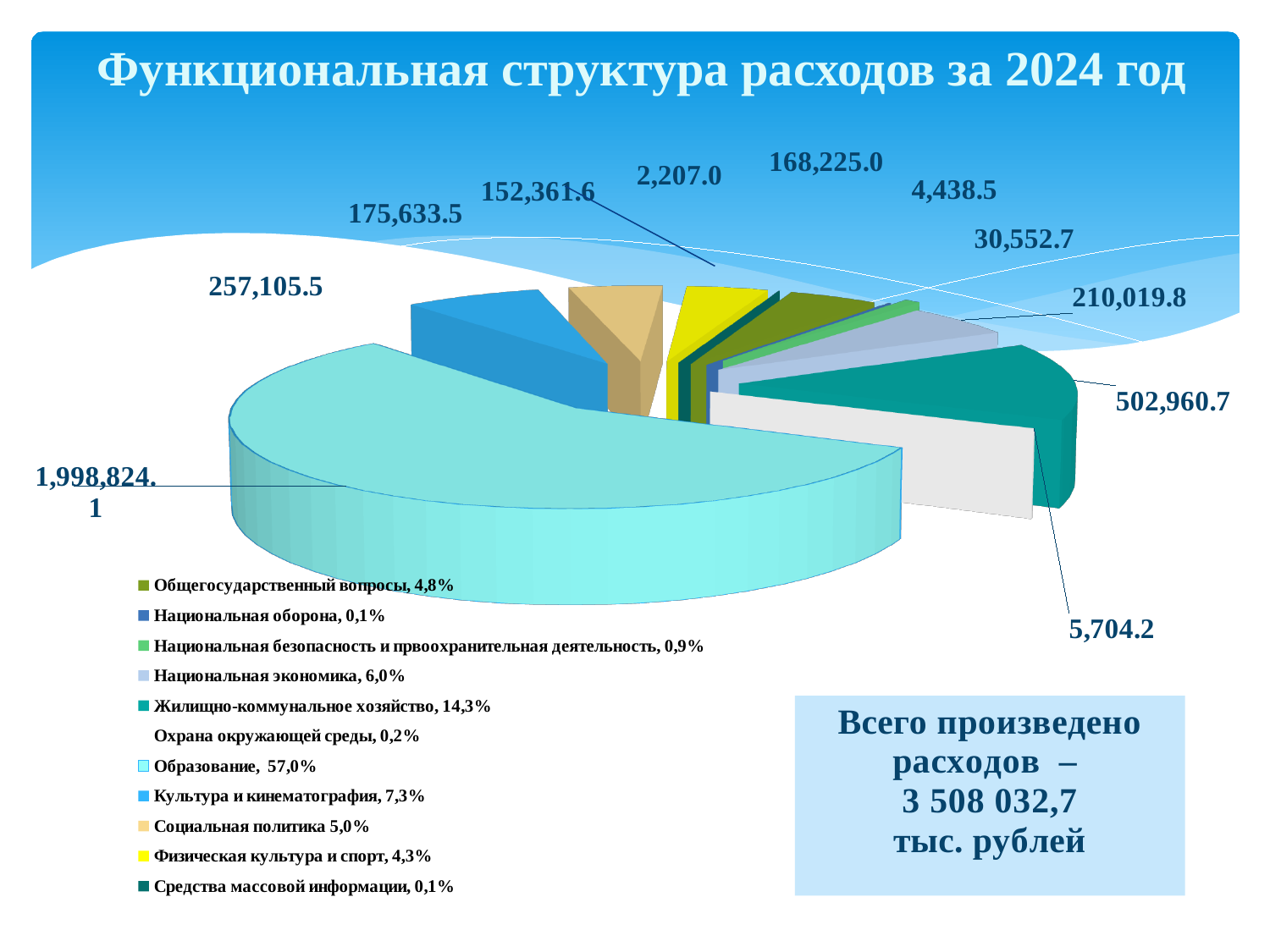
What share of the pie does Жилищно-коммунальное хозяйство account for, according to the legend? 14,3% What is the data label value for the largest slice (Образование)? 1,998,824.1 Which has the larger share: Культура и кинематография or Национальная экономика? Культура и кинематография What share does Общегосударственные вопросы have, according to the legend? 4,8% What is the title of the chart on the slide? Функциональная структура расходов за 2024 год Which category has the largest slice of the pie? Образование What kind of chart is shown on the slide? pie chart What is the data label value for the Жилищно-коммунальное хозяйство slice? 502,960.7 By how many percentage points does the share of Образование exceed the share of Жилищно-коммунальное хозяйство? 42,7% What share of the pie does Образование account for, according to the legend? 57,0% How many categories does the legend of the pie chart list? 11 What total expenditure is stated in the text box on the slide? 3 508 032,7 тыс. рублей